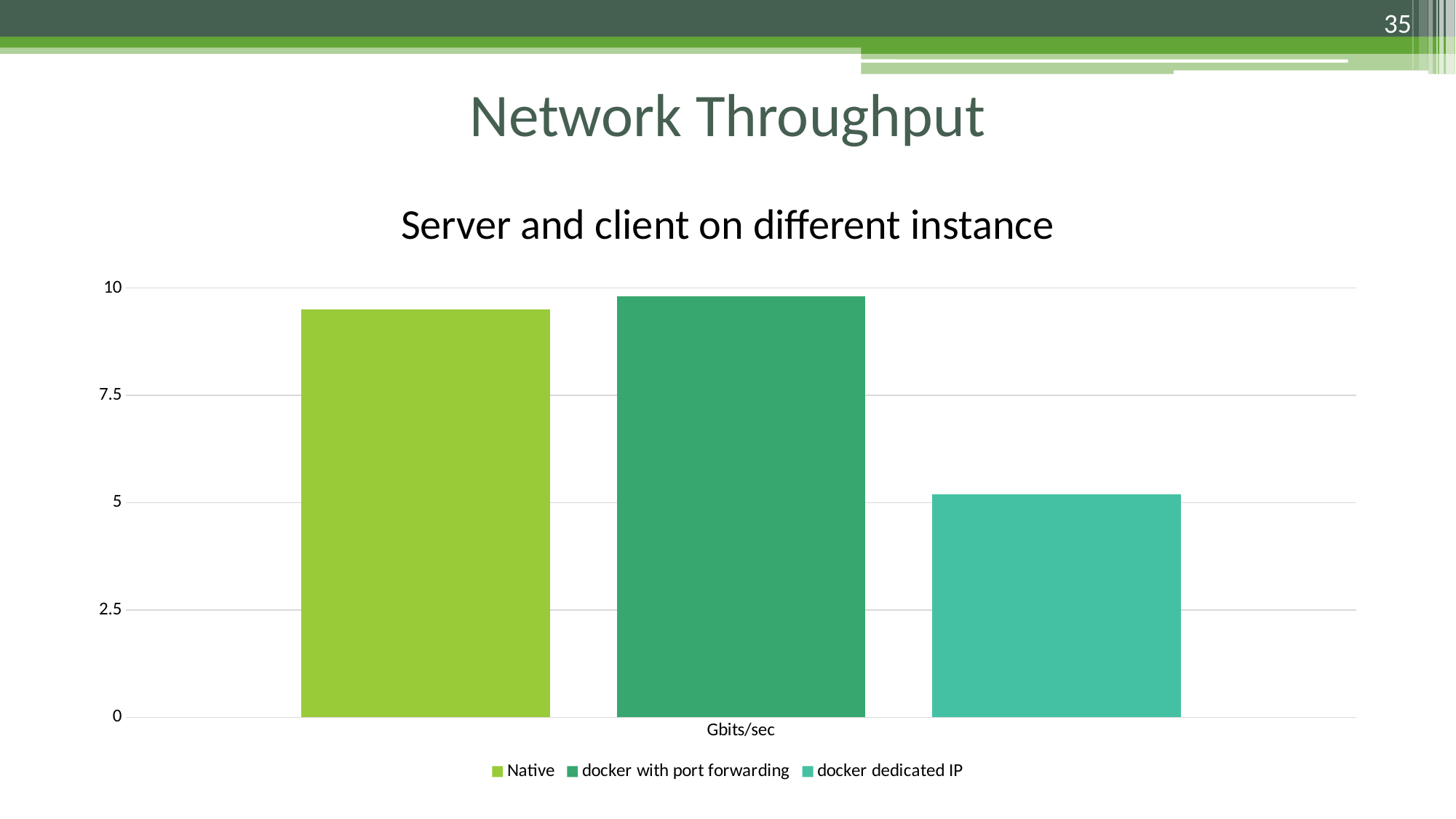
Is the value for docker with port forwarding greater or less than 10? less What unit label appears below the bars on the x axis? Gbits/sec Which series has the highest value? docker with port forwarding Is the value for docker dedicated IP greater or less than 7.5? less How many bars are plotted in the chart? 3 Which series has the lowest value? docker dedicated IP Is the value for Native greater or less than 7.5? greater How many series does the legend list? 3 What is the title of the chart? Server and client on different instance Which is larger, the value for Native or the value for docker dedicated IP? Native What kind of chart is shown on the slide? bar chart